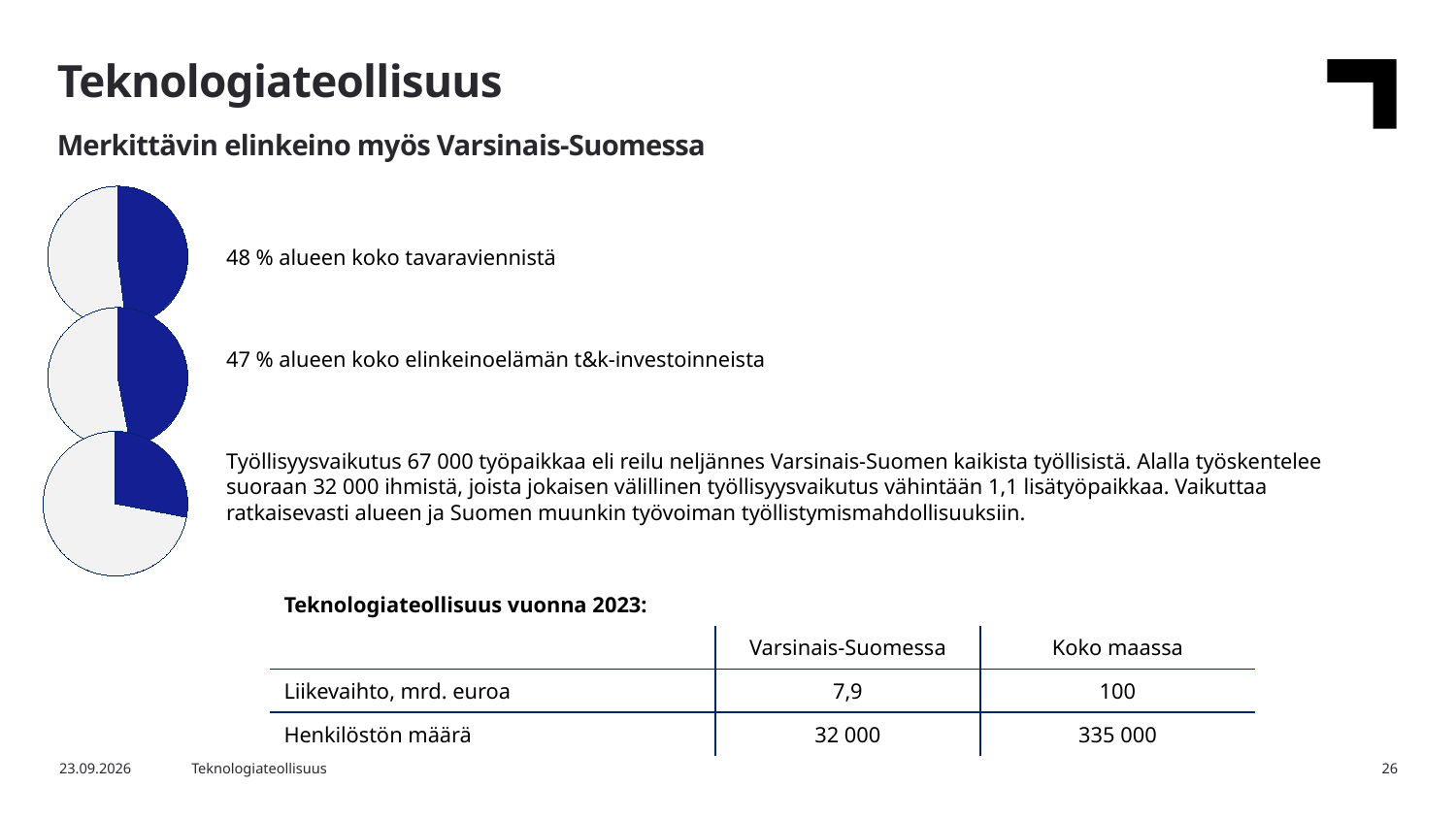
What does the top pie chart's blue slice represent? Alueen koko tavaraviennistä (share of the region's total goods exports) What share does the blue slice of the middle pie chart represent, according to the text beside it? 47 % Is the blue slice in the top pie chart larger or smaller than the blue slice in the bottom pie chart? Larger What kind of charts are shown on the left side of the slide? Pie charts Which of the three pie charts has the smallest blue slice? The bottom pie chart How many pie charts are on the slide? 3 What share does the blue slice of the top pie chart represent, according to the text beside it? 48 % What colour is used for the highlighted slice in each pie chart? Blue